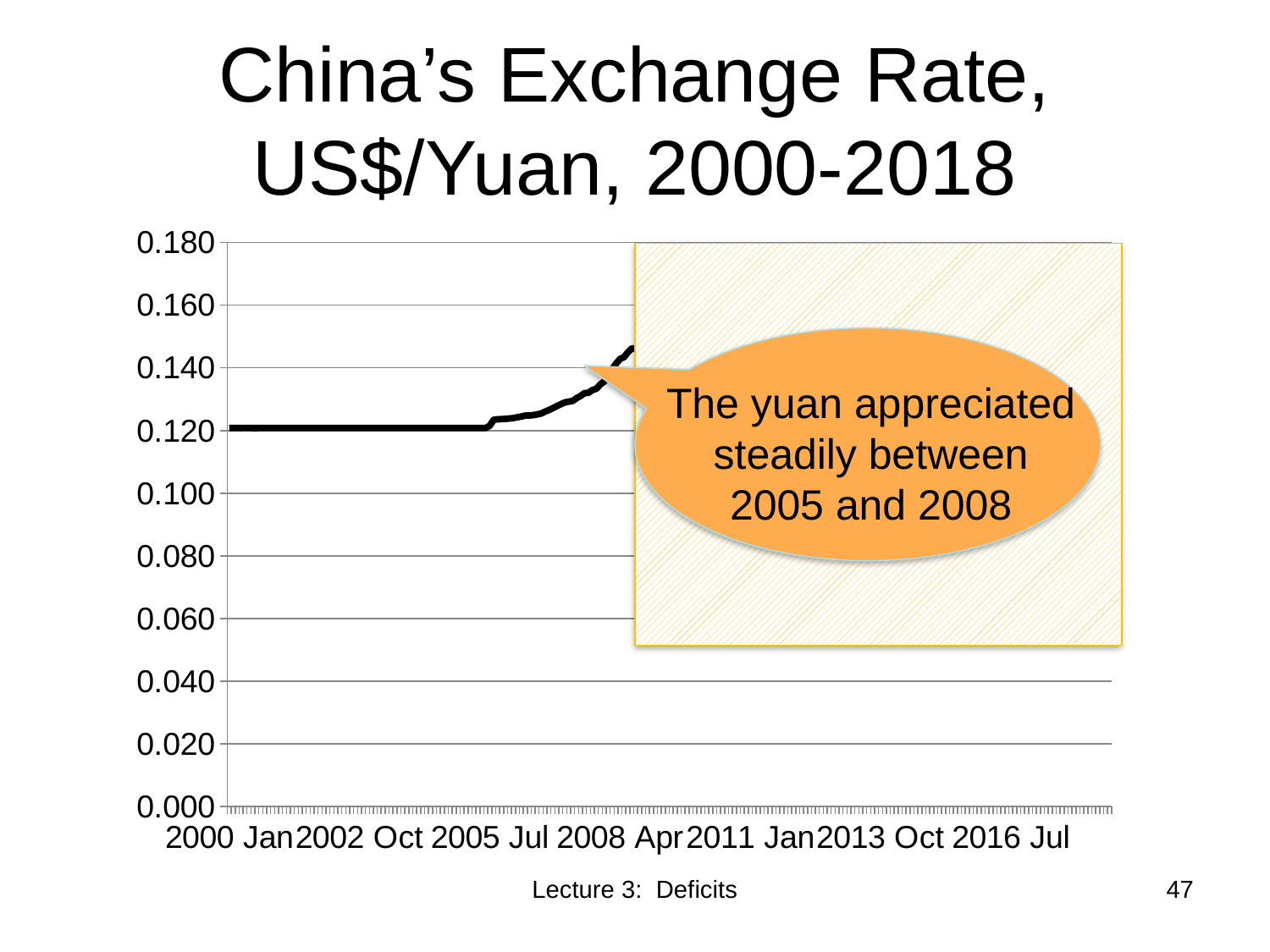
What is the highest value shown on the y axis? 0.180 Does the exchange rate rise or fall between 2005 Jul and 2008 Apr? rise How many date labels are shown on the x axis? 7 Is the exchange rate in 2000 Jan greater or less than 0.140? less Does the exchange rate rise, fall, or stay flat between 2000 Jan and 2005 Jul? stay flat What kind of chart is shown on the slide? line chart Is the exchange rate in 2000 Jan greater or less than 0.100? greater What is the title of the chart? China's Exchange Rate, US$/Yuan, 2000-2018 Which is larger, the exchange rate in 2002 Oct or in 2008 Apr? 2008 Apr